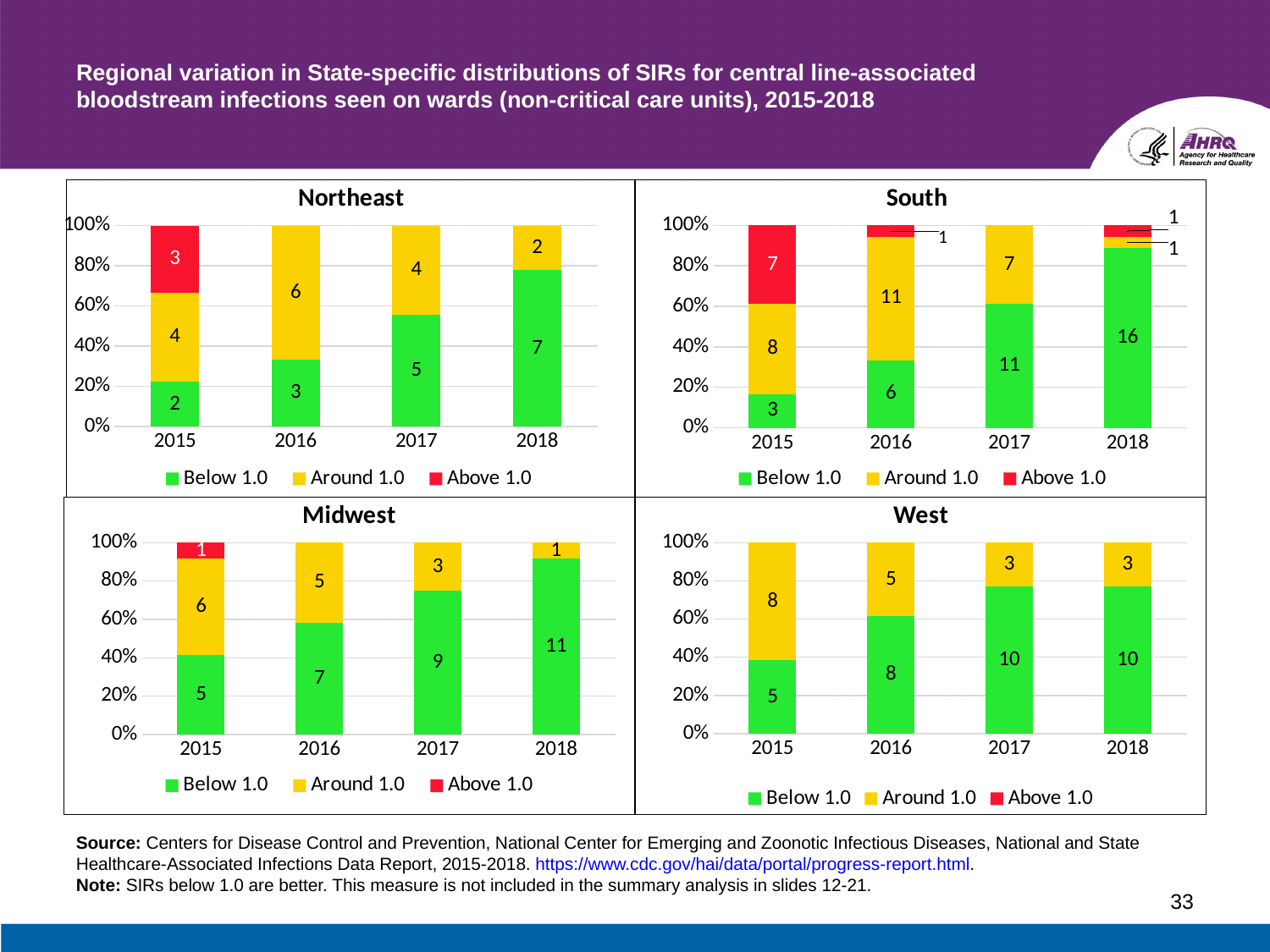
In the Midwest chart, how many states were Above 1.0 in 2015? 1 In the West chart, how many states were Around 1.0 in 2015? 8 In the Northeast chart, does the Below 1.0 count rise or fall from 2015 to 2018? rise In the West chart, which is larger: the Below 1.0 count in 2016 or the Around 1.0 count in 2016? Below 1.0 (8) In the South chart, which year has the highest Below 1.0 count? 2018 In the Northeast chart, how many states were Below 1.0 in 2018? 7 In the Northeast chart, what is the total number of states counted in the 2017 bar? 9 In the South chart, how many states were Around 1.0 in 2016? 11 In the Midwest chart, what is the difference between the Below 1.0 count in 2018 and in 2015? 6 What kind of chart is the West chart? stacked bar chart How many series does the legend of the Midwest chart list? 3 In the South chart, what is the total number of states counted in the 2015 bar? 18